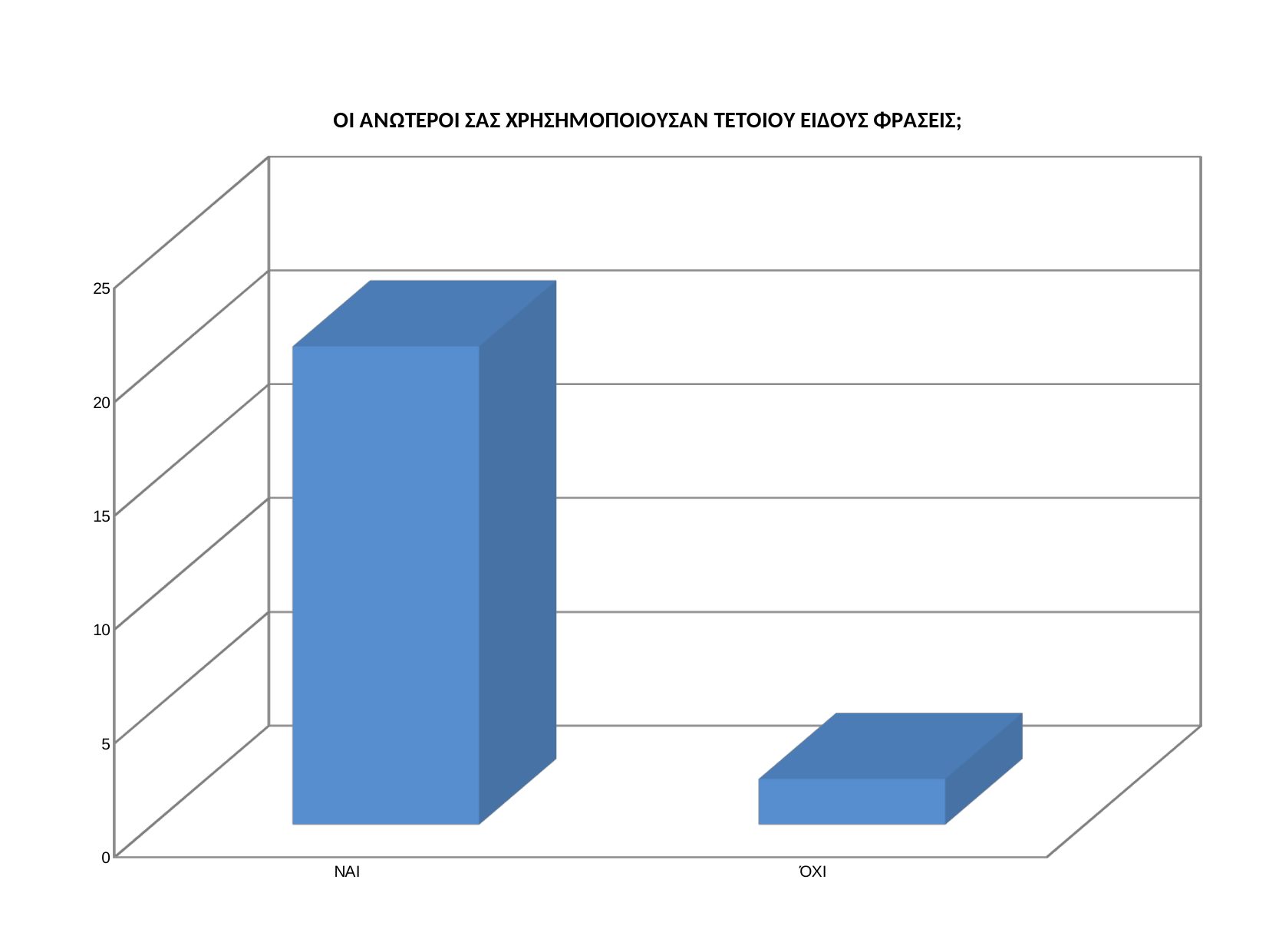
Which category has the lowest bar in the chart? ΌΧΙ Do the values fall or rise from ΝΑΙ to ΌΧΙ along the x axis? fall Which is larger, the value for ΝΑΙ or the value for ΌΧΙ? ΝΑΙ Is the value for ΌΧΙ greater or less than 10? less What kind of chart is shown on the slide? Bar chart What is the title of the chart? ΟΙ ΑΝΩΤΕΡΟΙ ΣΑΣ ΧΡΗΣΗΜΟΠΟΙΟΥΣΑΝ ΤΕΤΟΙΟΥ ΕΙΔΟΥΣ ΦΡΑΣΕΙΣ; Is the value for ΌΧΙ greater or less than 5? less What is the highest value labelled on the vertical axis of the chart? 25 How many categories are shown on the x axis of the chart? 2 Is the value for ΝΑΙ greater or less than 25? less Which category has the highest bar in the chart? ΝΑΙ